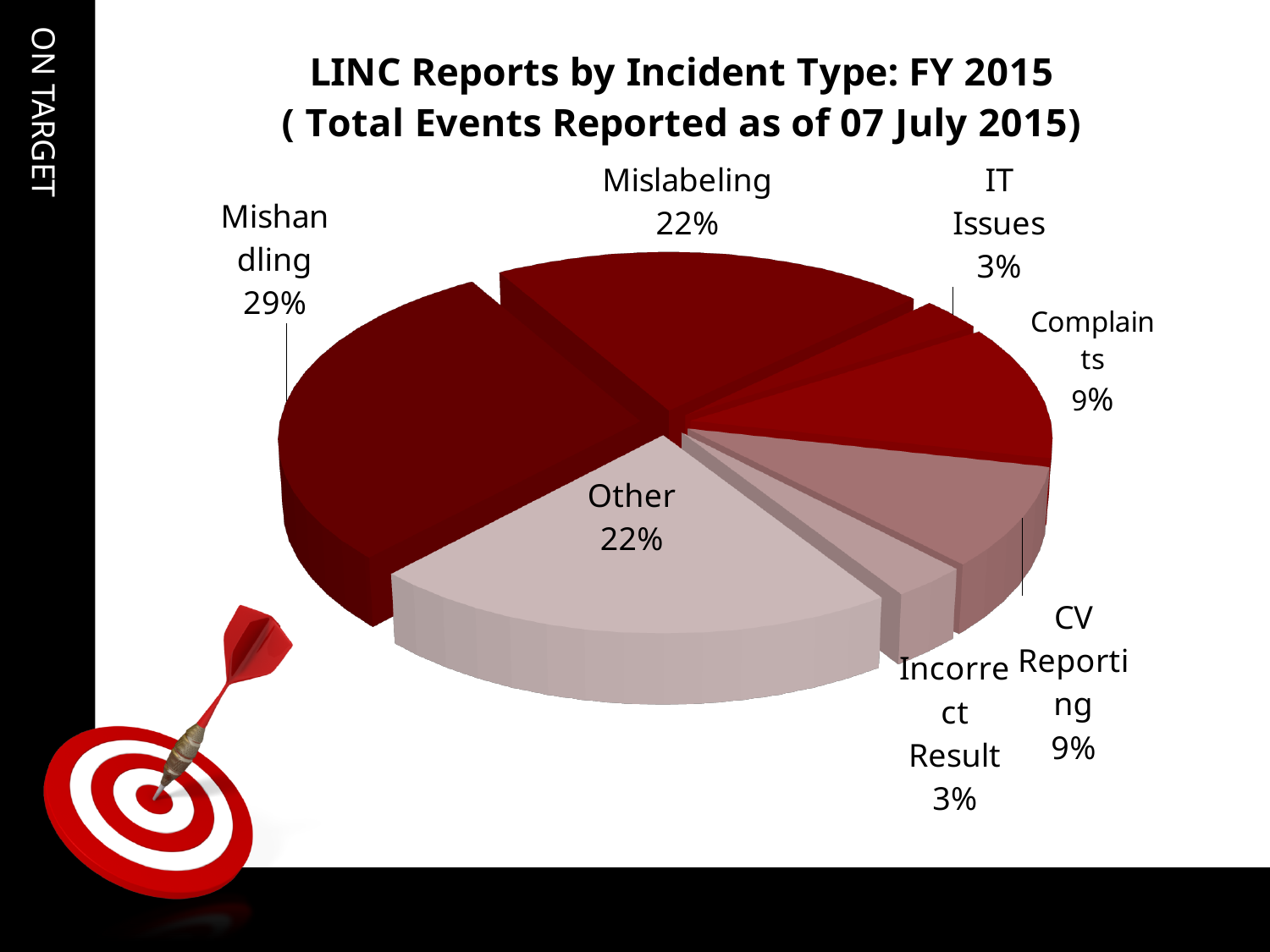
How many percentage points larger is the Mishandling share than the Mislabeling share? 7 What percentage is shown for IT Issues? 3% Which is larger, the share for Mishandling or the share for Mislabeling? Mishandling What percentage is shown for Complaints? 9% What share of the pie does Mislabeling represent? 22% How many incident type slices does the pie chart have? 7 What percentage is shown for CV Reporting? 9% What kind of chart is shown on the slide? pie chart What percentage of LINC reports is attributed to Mishandling? 29% What share of the pie is labeled Other? 22% Which incident type has the largest share of the pie? Mishandling What percentage is shown for Incorrect Result? 3%